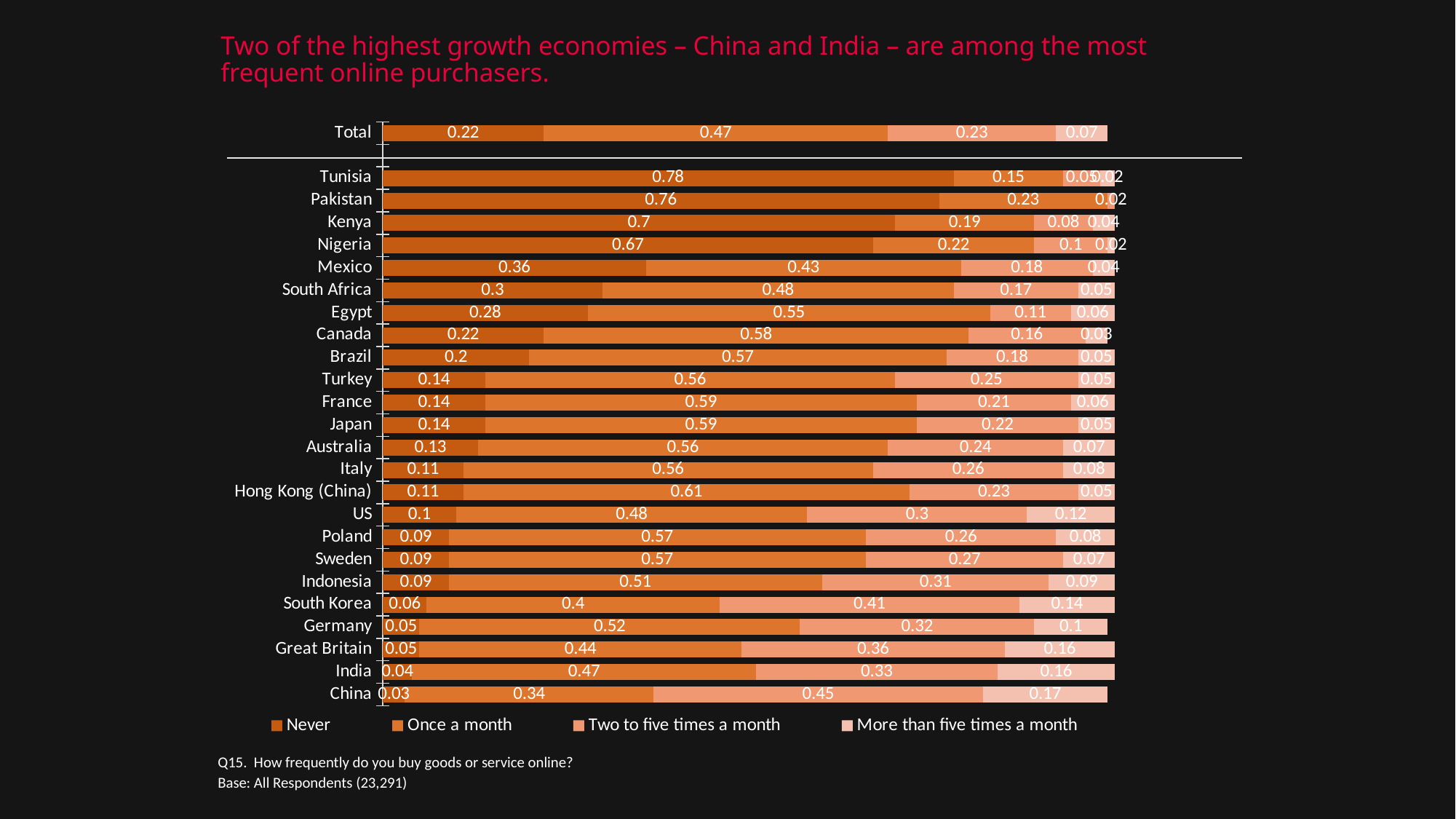
Which country has the highest 'Never' value? Tunisia How many countries are listed in the chart, excluding the Total row? 24 Which country has the lowest 'Never' value? China What is the difference between the 'Never' values for Tunisia and China? 0.75 What kind of chart is shown on the slide? Stacked bar chart What is the 'Once a month' value for Hong Kong (China)? 0.61 How many series does the legend list? 4 What is the 'Never' value for Tunisia? 0.78 Which has the larger 'Once a month' value, Germany or Great Britain? Germany Which country has the highest 'Two to five times a month' value? China What is the 'More than five times a month' value for China? 0.17 What is the 'Two to five times a month' value for the Total row? 0.23